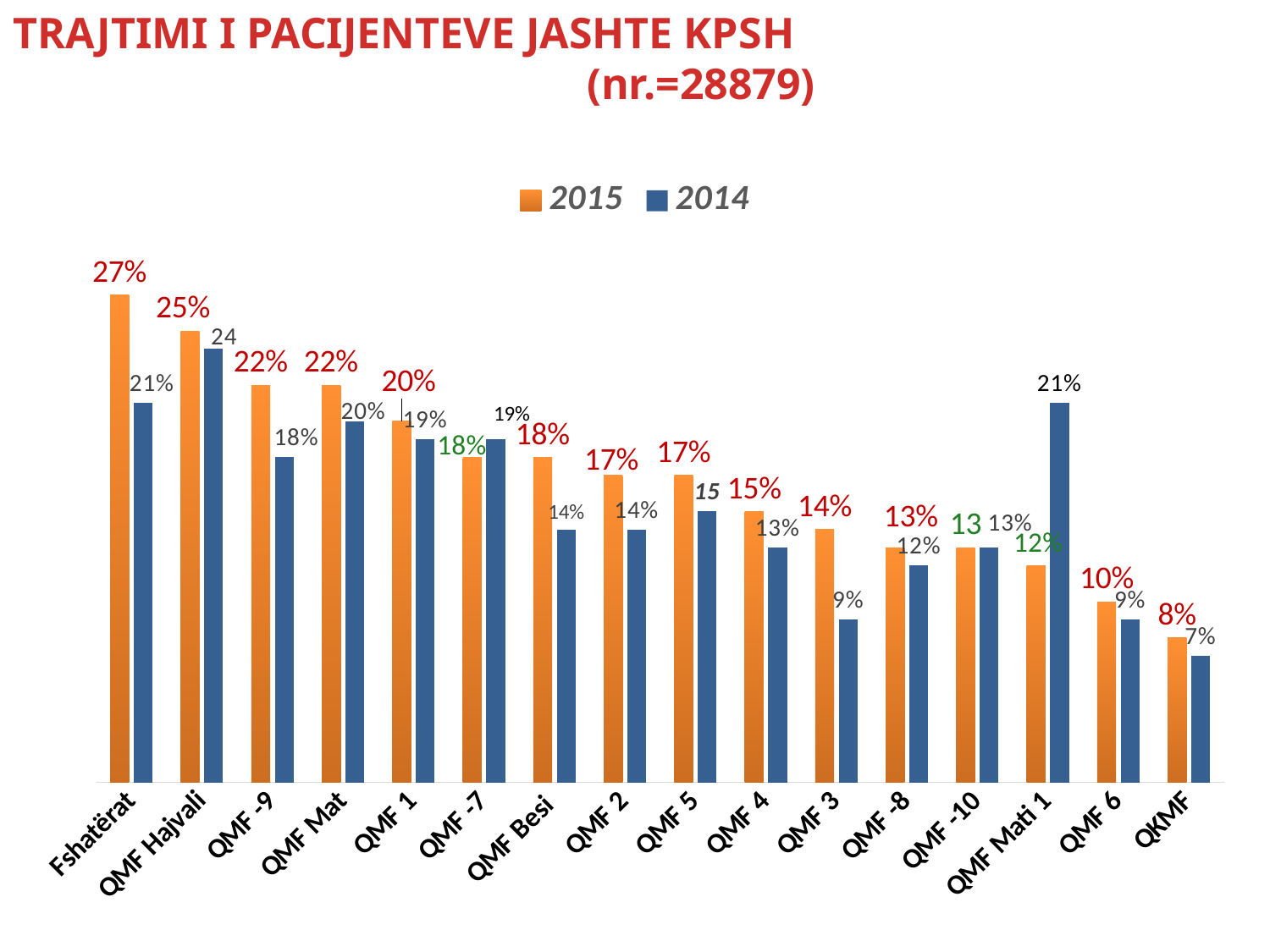
How many series does the legend list? 2 Which category has the lowest 2014 value? QKMF What is the 2014 value for QMF Mati 1? 21% What is the difference between the 2015 and 2014 values for QMF 3? 5% Which category has the highest 2015 value? Fshatërat How many categories are shown on the x axis? 16 What kind of chart is shown on the slide? Bar chart Which colour represents the 2015 series in the legend? Orange What is the 2015 value for Fshatërat? 27% What is the 2014 value for QMF Hajvali? 24 What is the 2015 value for QMF 3? 14% Which is larger for QMF Mati 1, the 2015 value or the 2014 value? 2014